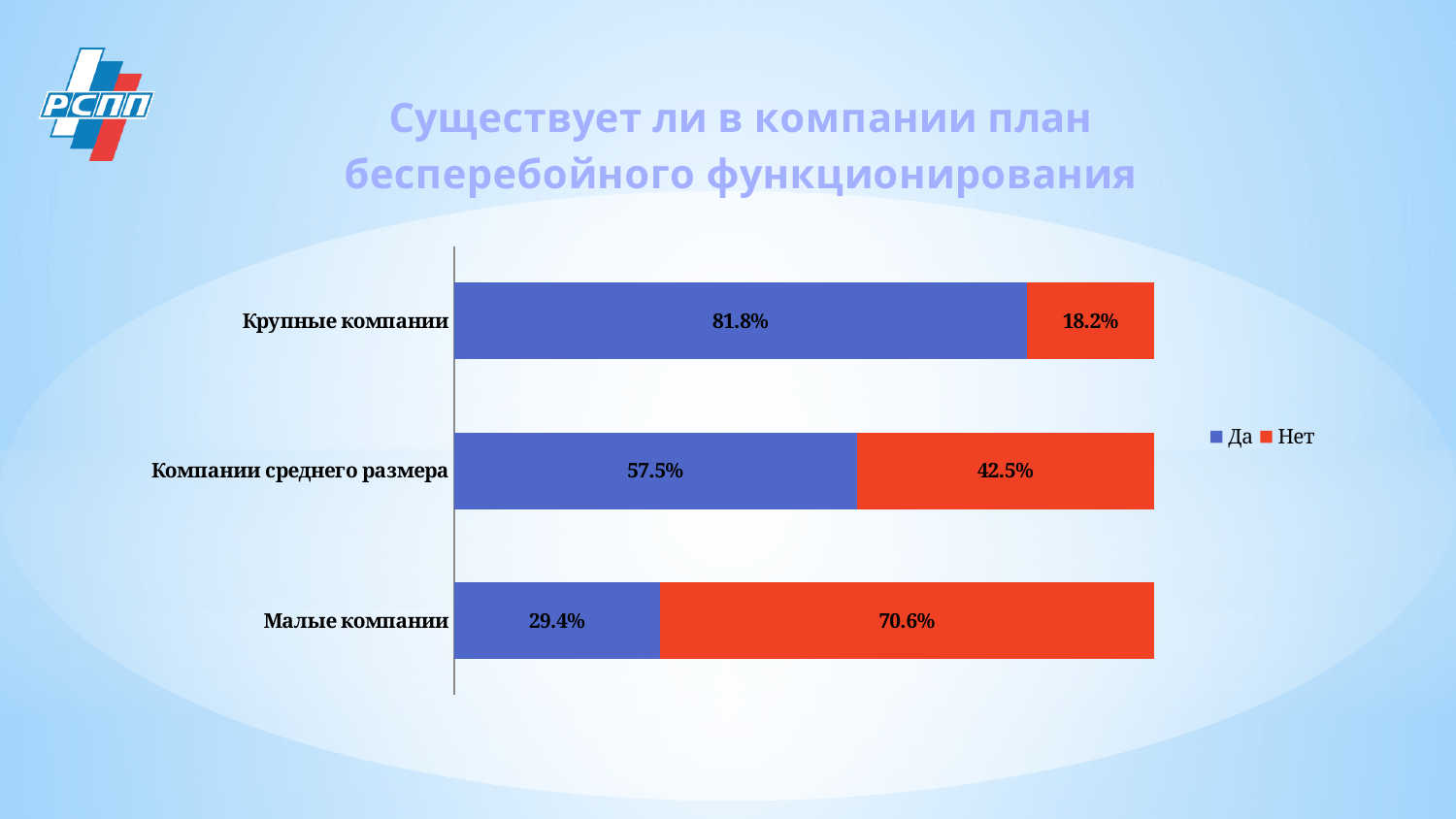
Which category has the highest "Да" value? Крупные компании What is the "Нет" value for Малые компании? 70.6% What is the "Да" value for Крупные компании? 81.8% What kind of chart is shown on the slide? Stacked bar chart How many categories are shown in the chart? 3 Which is larger for Малые компании: the "Да" value or the "Нет" value? Нет What is the difference between the "Да" values for Крупные компании and Малые компании? 52.4% How many series does the legend list? 2 Which category has the lowest "Нет" value? Крупные компании What is the total of the stacked bar for Компании среднего размера? 100% What is the "Нет" value for Компании среднего размера? 42.5% What is the "Да" value for Компании среднего размера? 57.5%